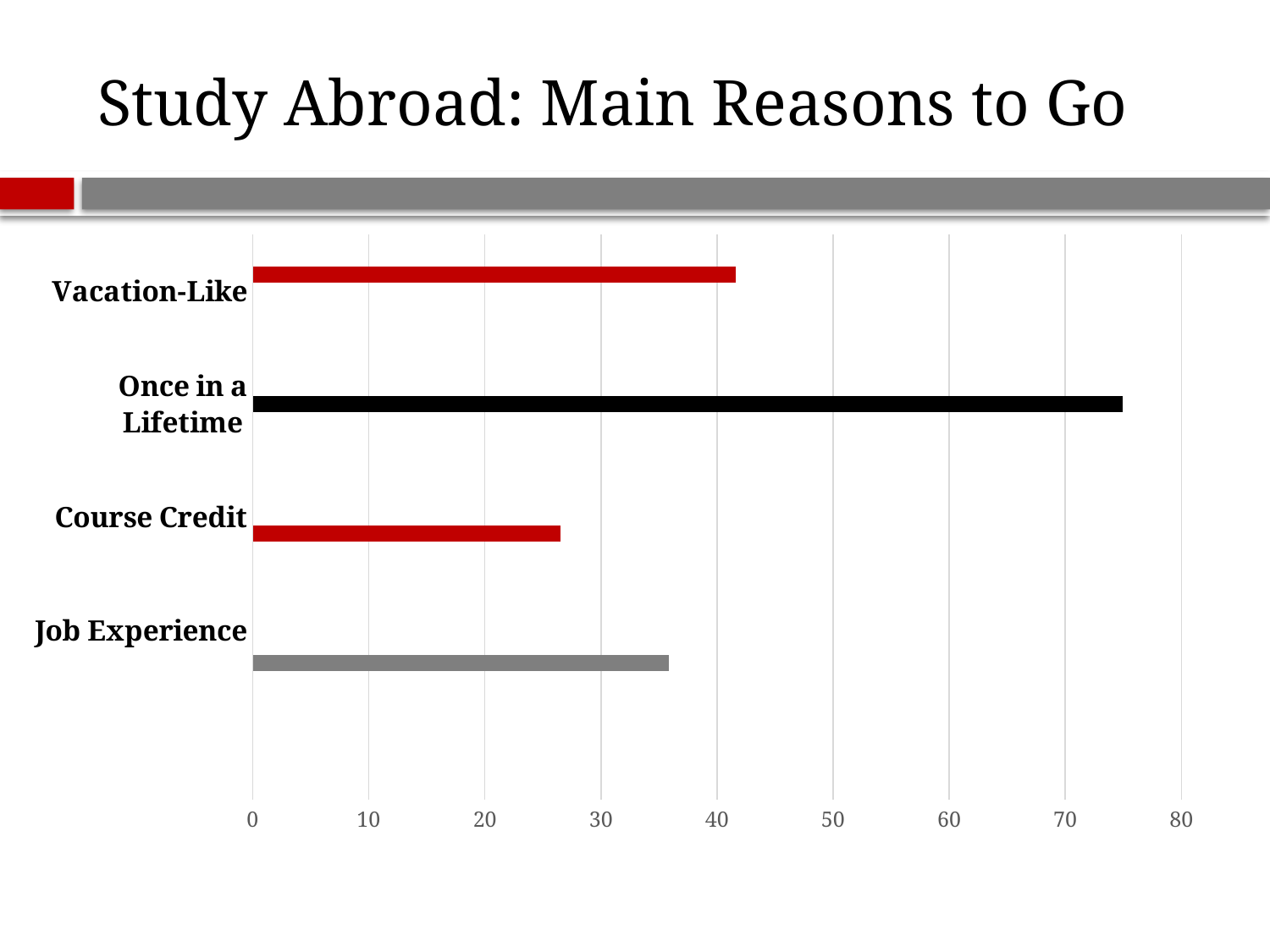
Which is larger, the value for Course Credit or the value for Job Experience? Job Experience Is the value for Vacation-Like greater or less than 50? less How many categories are plotted in the chart? 4 Is the value for Course Credit greater or less than 30? less Is the value for Once in a Lifetime greater or less than 70? greater Which is larger, the value for Vacation-Like or the value for Job Experience? Vacation-Like What colour is the bar for Once in a Lifetime? black Which category has the lowest value in the chart? Course Credit What kind of chart is shown on the slide? bar chart Which category has the highest value in the chart? Once in a Lifetime What is the title of the slide containing the chart? Study Abroad: Main Reasons to Go